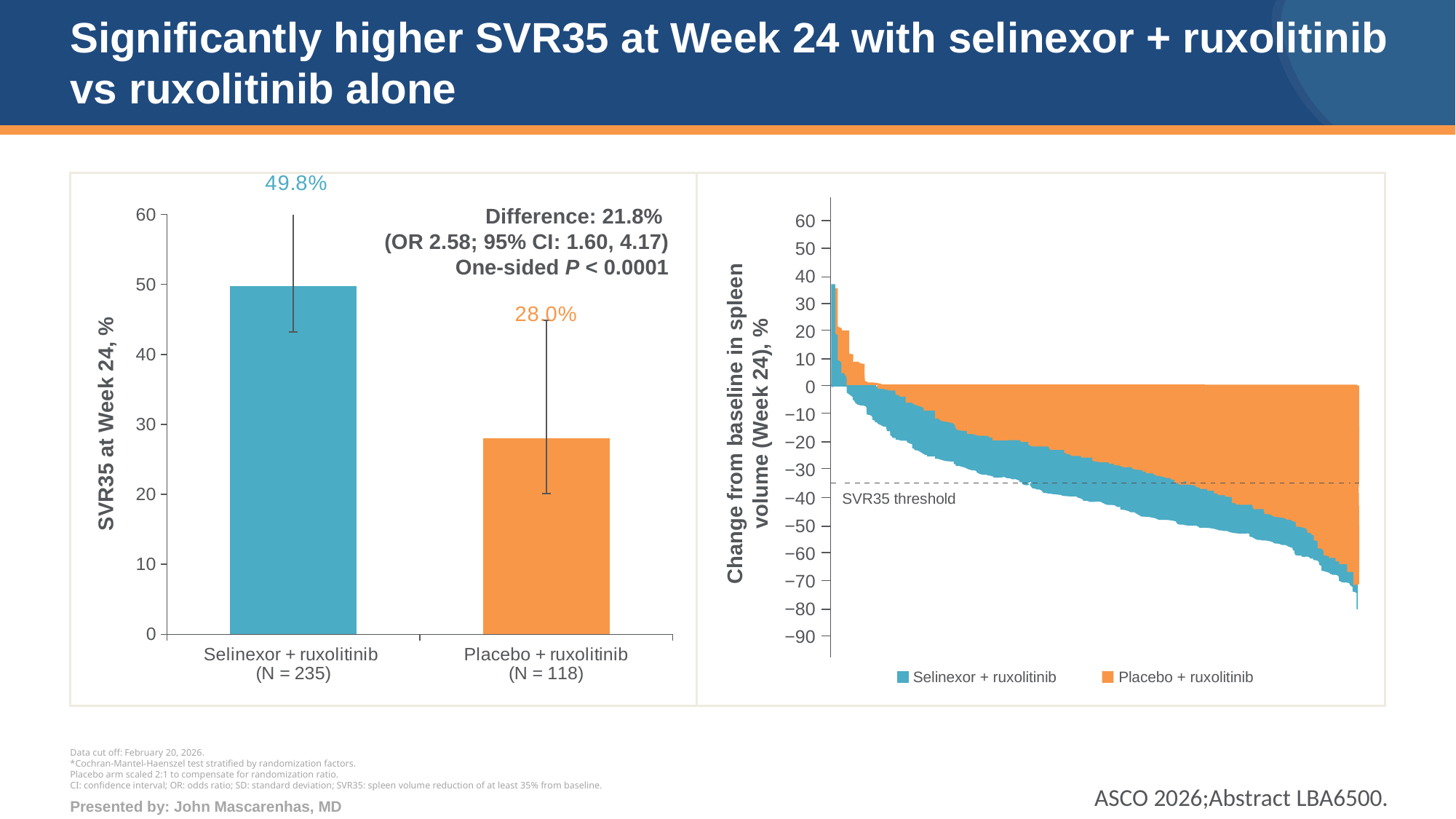
On the right chart (Change from baseline in spleen volume), which colour represents Placebo + ruxolitinib? Orange On the left chart (SVR35 at Week 24), what is the SVR35 rate for Selinexor + ruxolitinib? 49.8% On the left chart (SVR35 at Week 24), how many treatment arms are plotted? 2 On the right chart (Change from baseline in spleen volume), do the plotted values rise or fall from left to right along the x axis? Fall What kind of chart is the left chart (SVR35 at Week 24)? Bar chart On the left chart (SVR35 at Week 24), what is the SVR35 rate for Placebo + ruxolitinib? 28.0% On the left chart (SVR35 at Week 24), what is the number of patients in the Selinexor + ruxolitinib arm? N = 235 On the left chart (SVR35 at Week 24), which treatment arm has the higher SVR35 rate? Selinexor + ruxolitinib On the left chart (SVR35 at Week 24), what is the difference between the SVR35 rates of the two arms? 21.8% On the left chart (SVR35 at Week 24), is the value for Placebo + ruxolitinib greater or less than 30? less On the right chart (Change from baseline in spleen volume), what is the dashed horizontal line labelled? SVR35 threshold On the right chart (Change from baseline in spleen volume), how many series does the legend list? 2